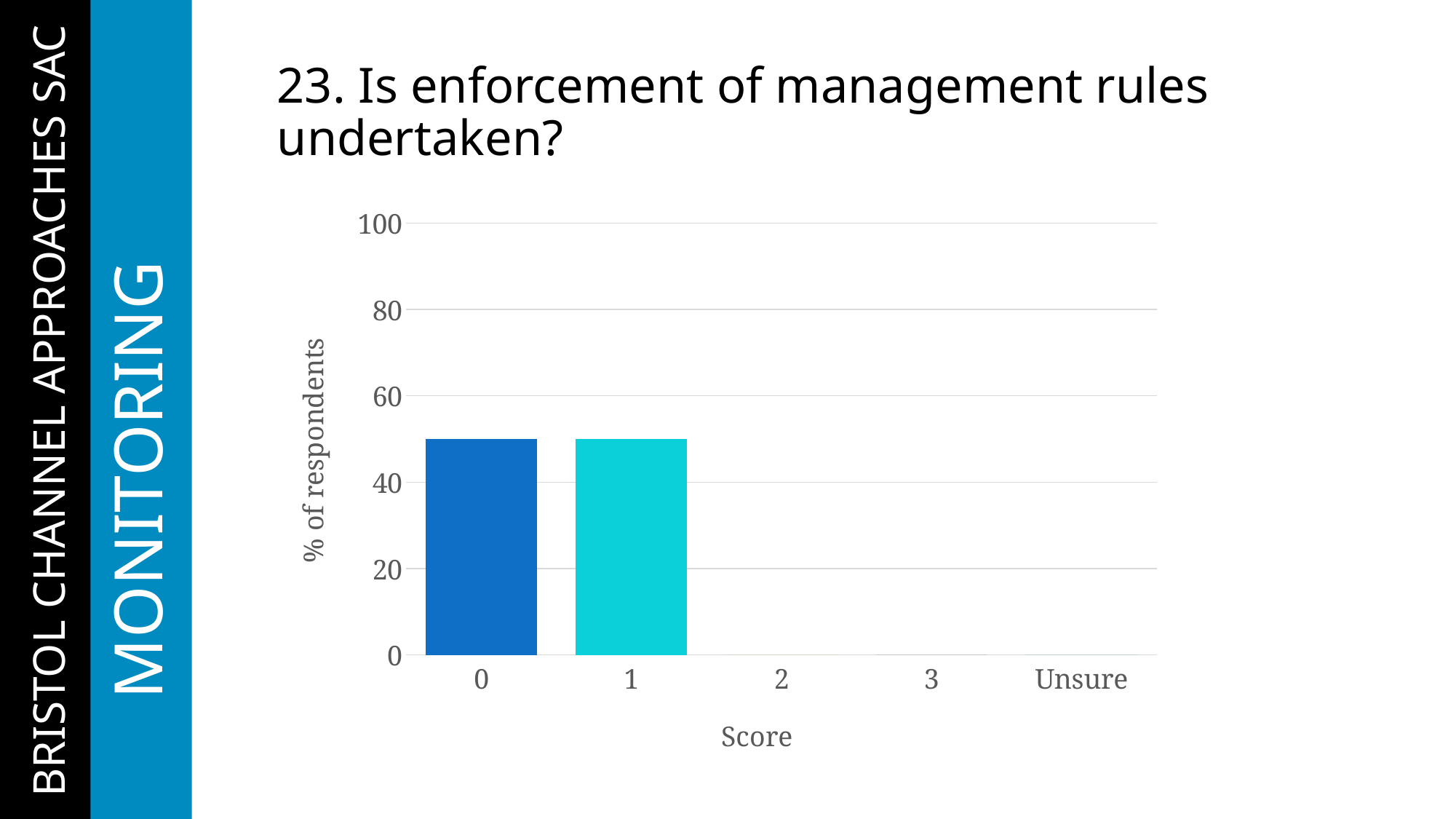
Is the value for score 1 greater or less than 60? less How many score categories are shown on the x axis? 5 What is the label of the y axis? % of respondents Which score categories have no visible bar? 2, 3 and Unsure Is the value for score 0 greater or less than 60? less How many categories have a visible bar? 2 Is the value for score 0 greater or less than 40? greater What is the highest value shown on the y axis? 100 What kind of chart is shown on the slide? bar chart